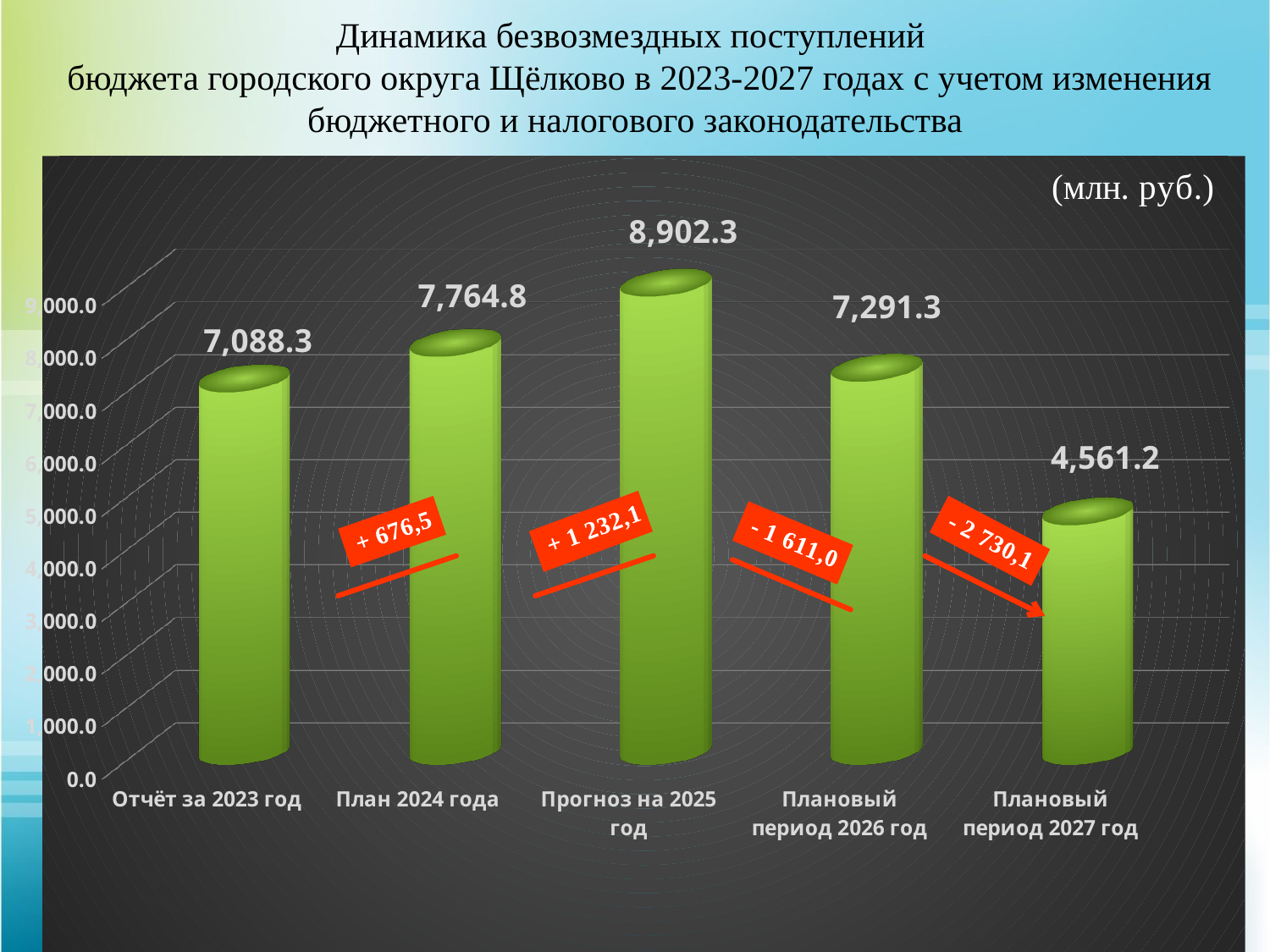
How many categories are shown on the x axis? 5 Which is larger: the value for «Плановый период 2026 год» or the value for «Отчёт за 2023 год»? Плановый период 2026 год Which category has the lowest value? Плановый период 2027 год What is the difference between the values for «План 2024 года» and «Отчёт за 2023 год»? 676.5 What is the value for «Прогноз на 2025 год»? 8,902.3 Which category has the highest value? Прогноз на 2025 год What is the value for «План 2024 года»? 7,764.8 What unit of measurement is indicated in the top right corner of the chart? млн. руб. What is the value for «Отчёт за 2023 год»? 7,088.3 What is the value for «Плановый период 2027 год»? 4,561.2 What is the difference between the values for «Плановый период 2026 год» and «Плановый период 2027 год»? 2,730.1 What kind of chart is shown on the slide? Bar chart